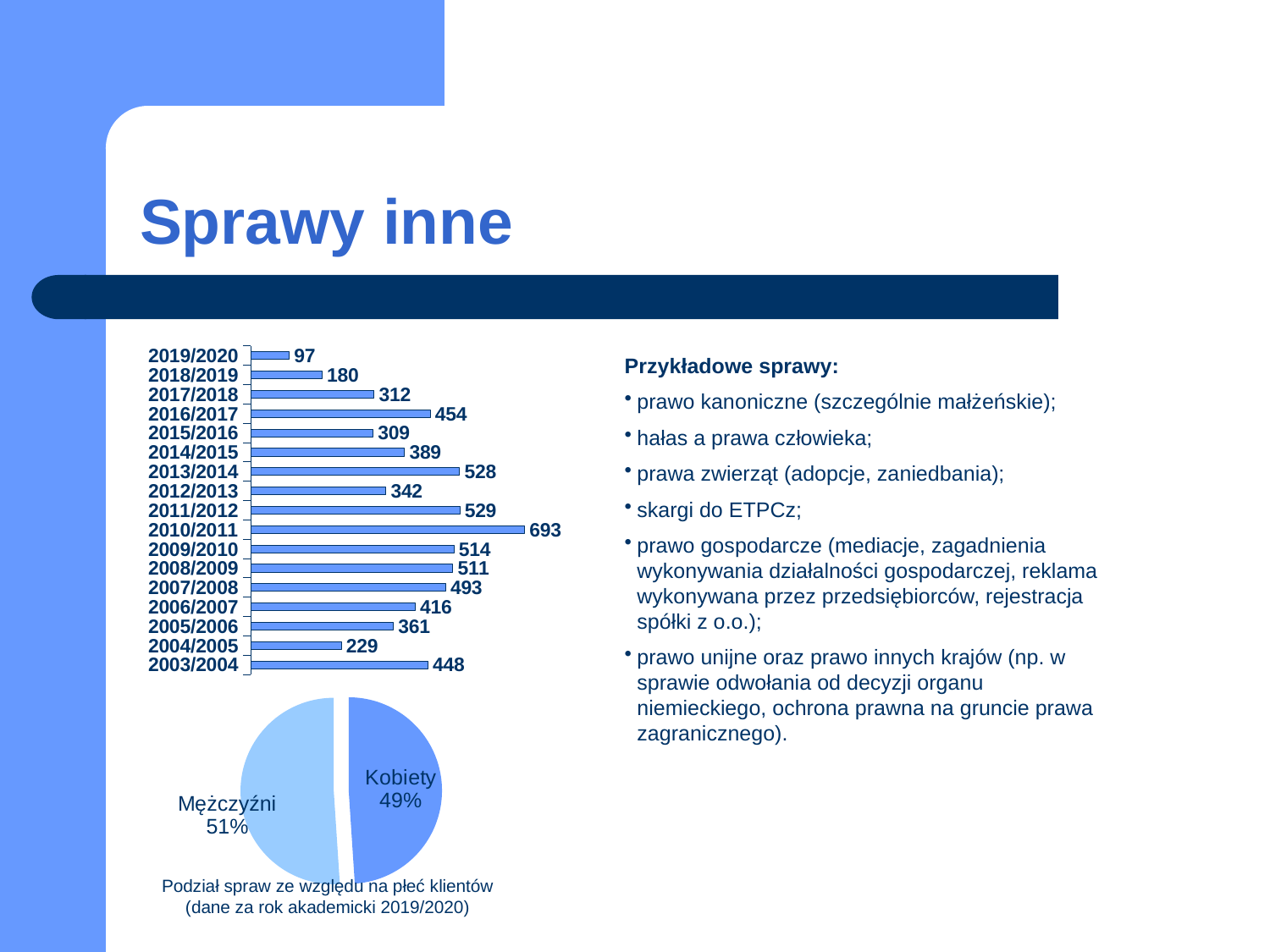
In the bar chart at the top left, which academic year has the lowest value? 2019/2020 In the bar chart at the top left, what is the difference between the values for 2016/2017 and 2015/2016? 145 In the bar chart at the top left, which is larger, the value for 2013/2014 or the value for 2012/2013? 2013/2014 In the pie chart at the bottom left, what share is labelled Kobiety? 49% In the bar chart at the top left, which academic year has the highest value? 2010/2011 In the bar chart at the top left, what is the value for 2019/2020? 97 What type of chart is the chart at the top left of the slide? bar chart What is the caption below the pie chart at the bottom left? Podział spraw ze względu na płeć klientów (dane za rok akademicki 2019/2020) How many academic years are shown in the bar chart at the top left? 17 In the pie chart at the bottom left, what share is labelled Mężczyźni? 51% In the bar chart at the top left, what is the value for 2010/2011? 693 In the bar chart at the top left, what is the value for 2003/2004? 448